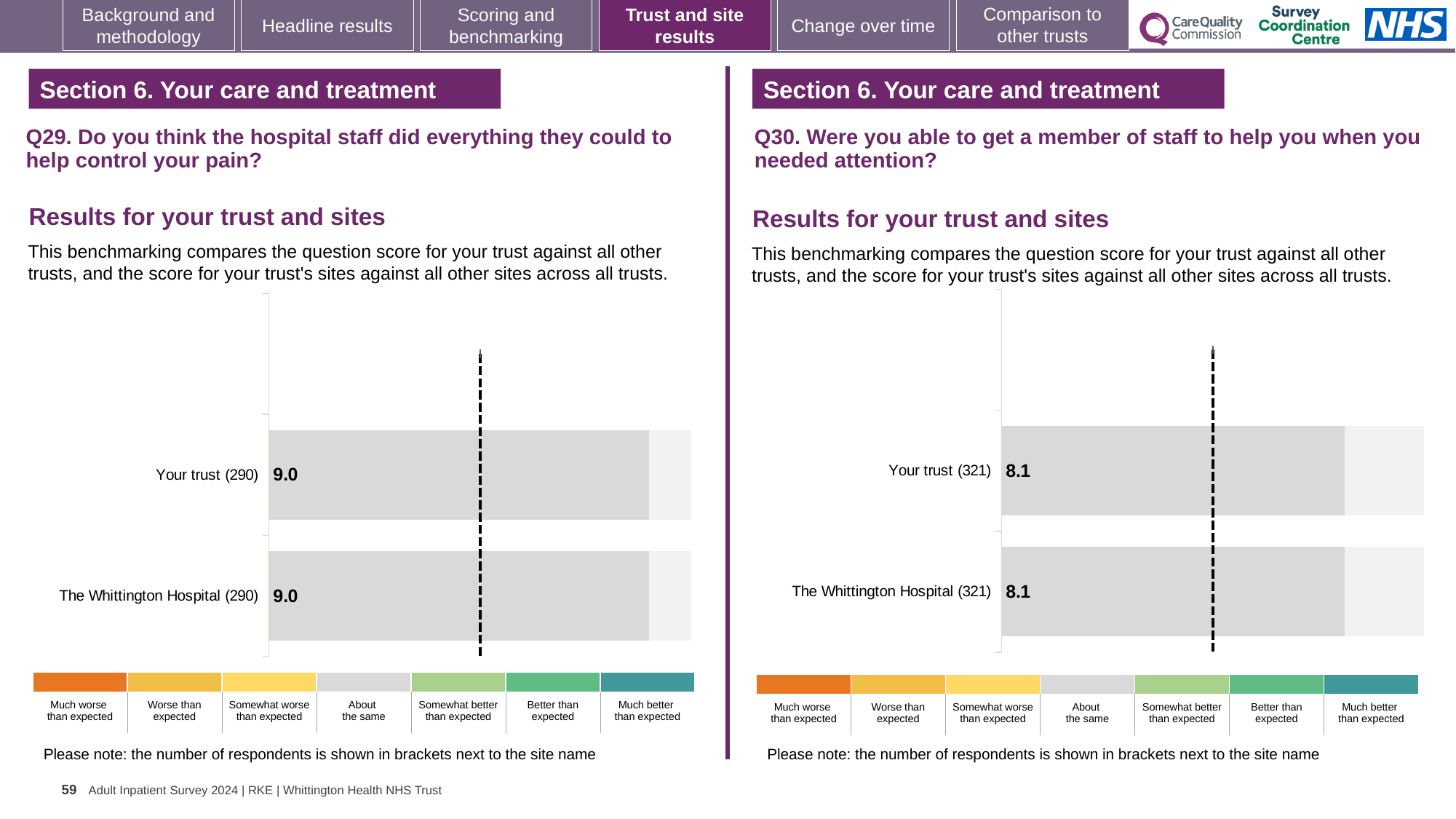
On the Q29 chart (left), what is the difference between the score for Your trust and the score for The Whittington Hospital? 0.0 On the Q29 chart (left), what is the score for Your trust? 9.0 On the Q29 chart (left), how many respondents are shown in brackets next to Your trust? 290 How many bars are plotted on the Q30 chart (right)? 2 How many categories does the colour key below the Q30 chart (right) list? 7 On the Q30 chart (right), what is the score for Your trust? 8.1 On the Q30 chart (right), what is the score for The Whittington Hospital? 8.1 On the Q30 chart (right), what is the difference between the score for Your trust and the score for The Whittington Hospital? 0.0 What kind of chart is the Q29 chart (left)? Bar chart On the Q30 chart (right), how many respondents are shown in brackets next to The Whittington Hospital? 321 How many bars are plotted on the Q29 chart (left)? 2 On the Q29 chart (left), what is the score for The Whittington Hospital? 9.0